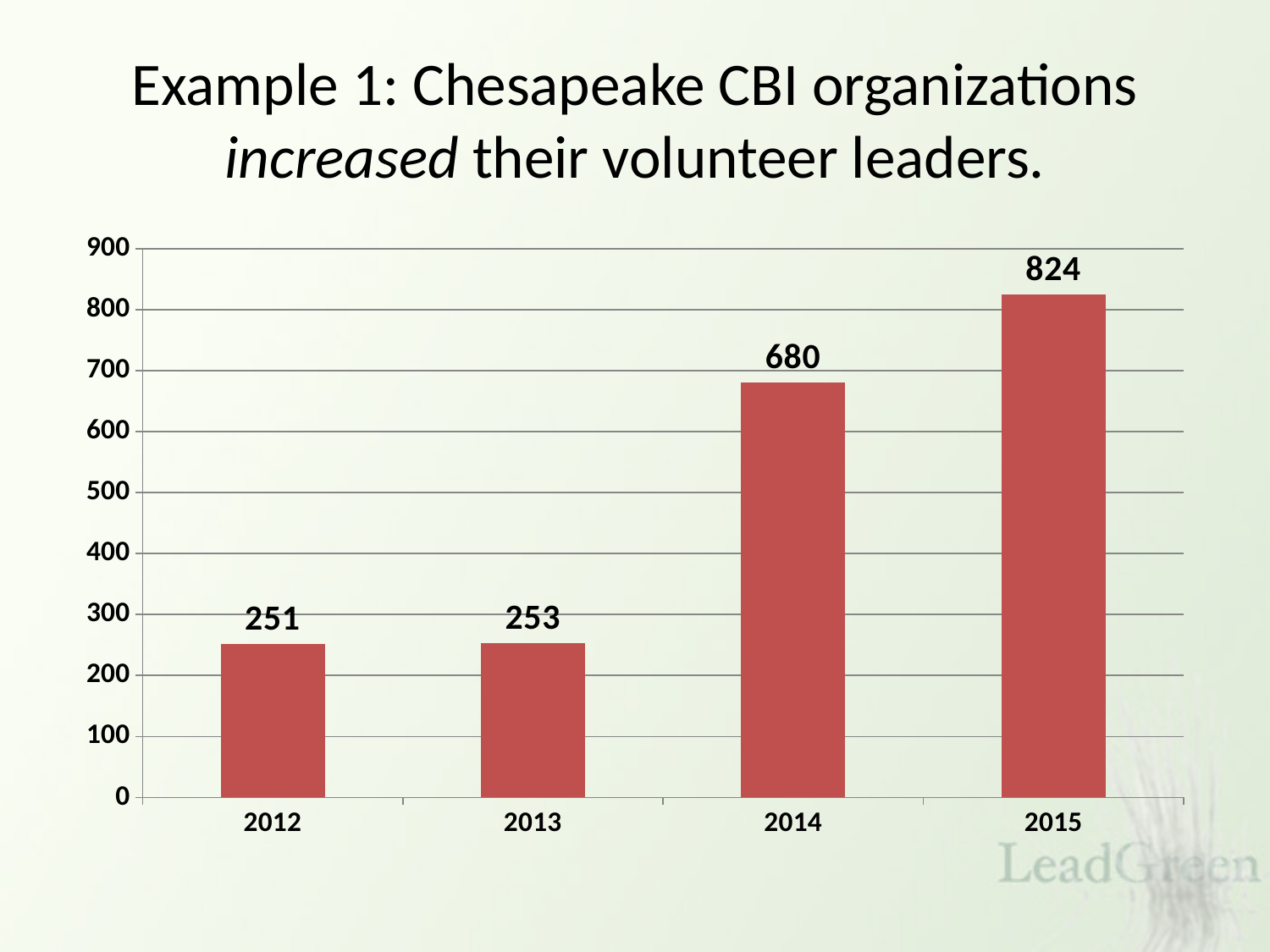
How many years are shown on the x axis? 4 Which year has the highest value? 2015 Is the value for 2015 greater or less than 800? greater Which is larger, the value for 2014 or the value for 2013? 2014 What is the difference between the values for 2015 and 2014? 144 Which year has the lowest value? 2012 What is the value for 2015? 824 Do the values rise or fall from 2012 to 2015? rise What kind of chart is shown on the slide? bar chart What is the value for 2014? 680 What is the value for 2012? 251 What is the difference between the values for 2013 and 2012? 2